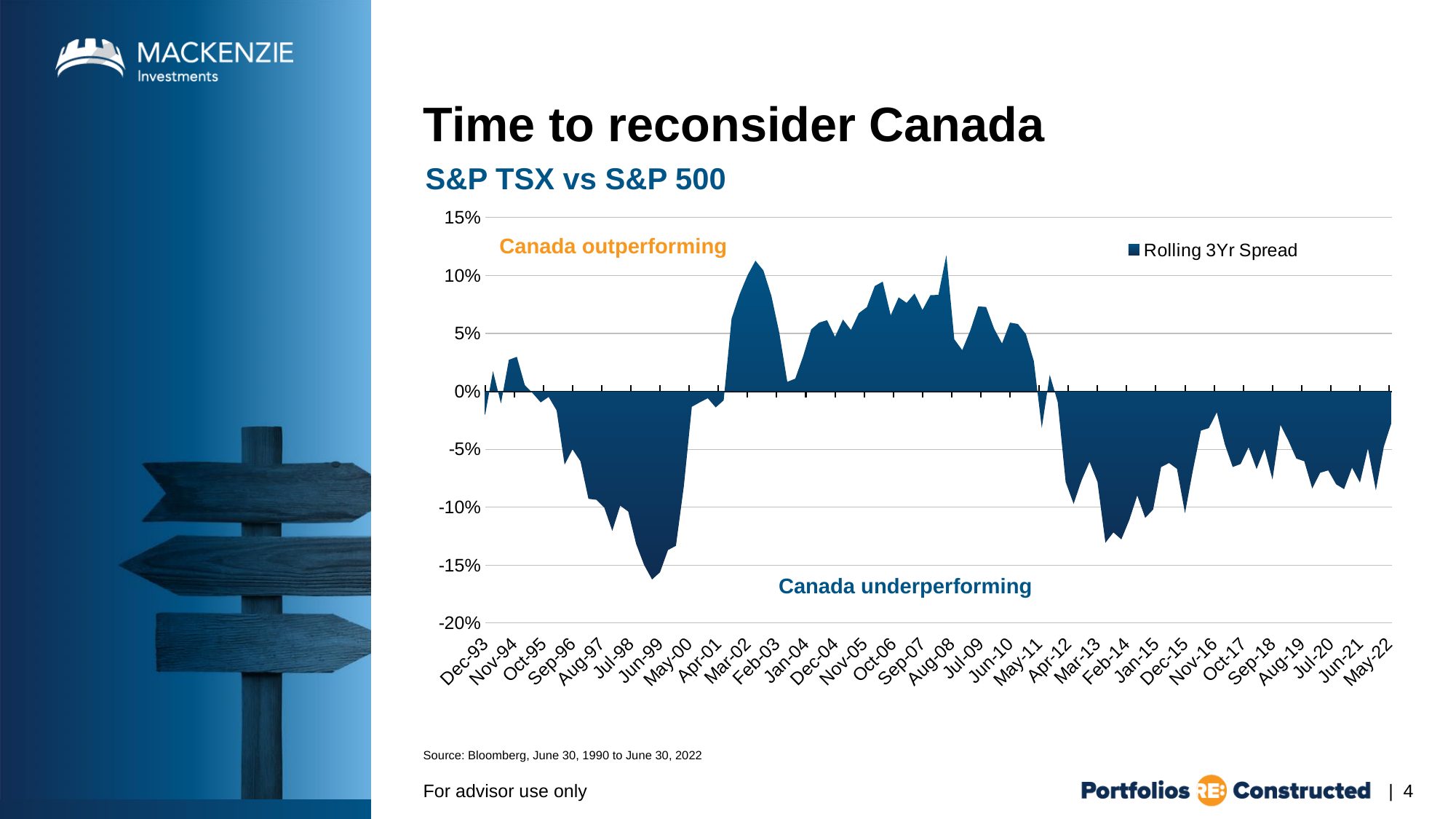
What label is shown for the region above 0% on the chart? Canada outperforming Is the value of the Rolling 3Yr Spread around May-22 greater or less than 0%? less How many series does the legend list? 1 Does the Rolling 3Yr Spread rise or fall between Jul-98 and Mar-02? Rise What kind of chart is shown on the slide? Area chart Which is larger, the Rolling 3Yr Spread around Mar-02 or around Jun-99? Mar-02 What is the name of the series shown in the legend? Rolling 3Yr Spread Is the value of the Rolling 3Yr Spread around Jul-98 greater or less than -5%? less Around which x-axis label does the Rolling 3Yr Spread reach its lowest point? Jun-99 Is the value of the Rolling 3Yr Spread around Oct-06 greater or less than 5%? greater